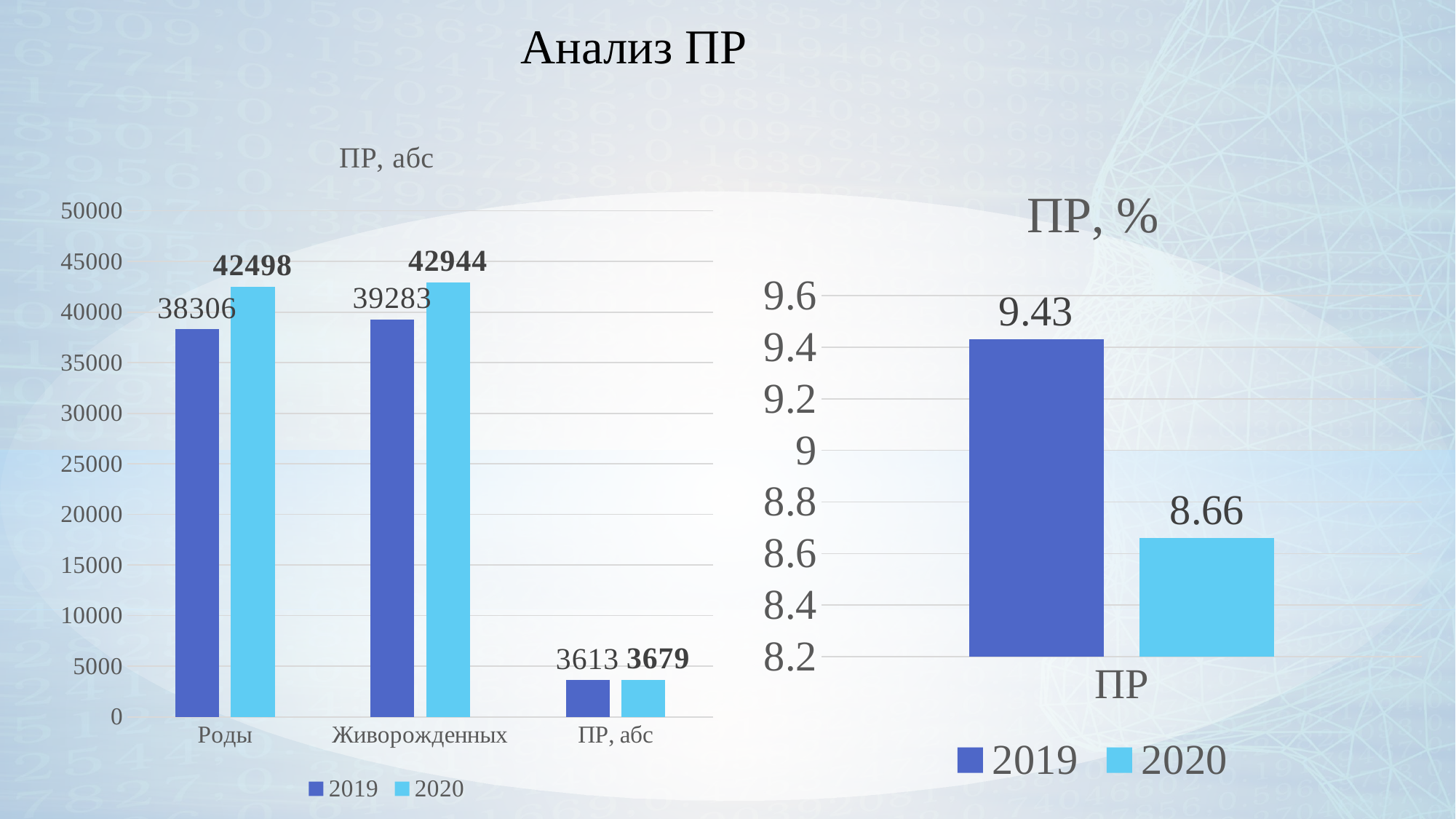
In the chart titled "ПР, абс", what is the value for Живорожденных in 2020? 42944 In the chart titled "ПР, абс", how many categories are shown on the x axis? 3 In the chart titled "ПР, %", what is the difference between the 2019 and 2020 values? 0.77 In the chart titled "ПР, абс", what is the value for the category "ПР, абс" in 2020? 3679 In the chart titled "ПР, абс", what is the value for Роды in 2019? 38306 In the chart titled "ПР, абс", how many series does the legend list? 2 In the chart titled "ПР, %", what is the value for 2020? 8.66 What kind of chart is the chart titled "ПР, %"? Bar chart In the chart titled "ПР, %", what is the value for 2019? 9.43 In the chart titled "ПР, абс", what is the difference between the 2020 and 2019 values for Роды? 4192 In the chart titled "ПР, абс", which is larger for Живорожденных: the 2019 value or the 2020 value? 2020 In the chart titled "ПР, абс", which category has the lowest values? ПР, абс